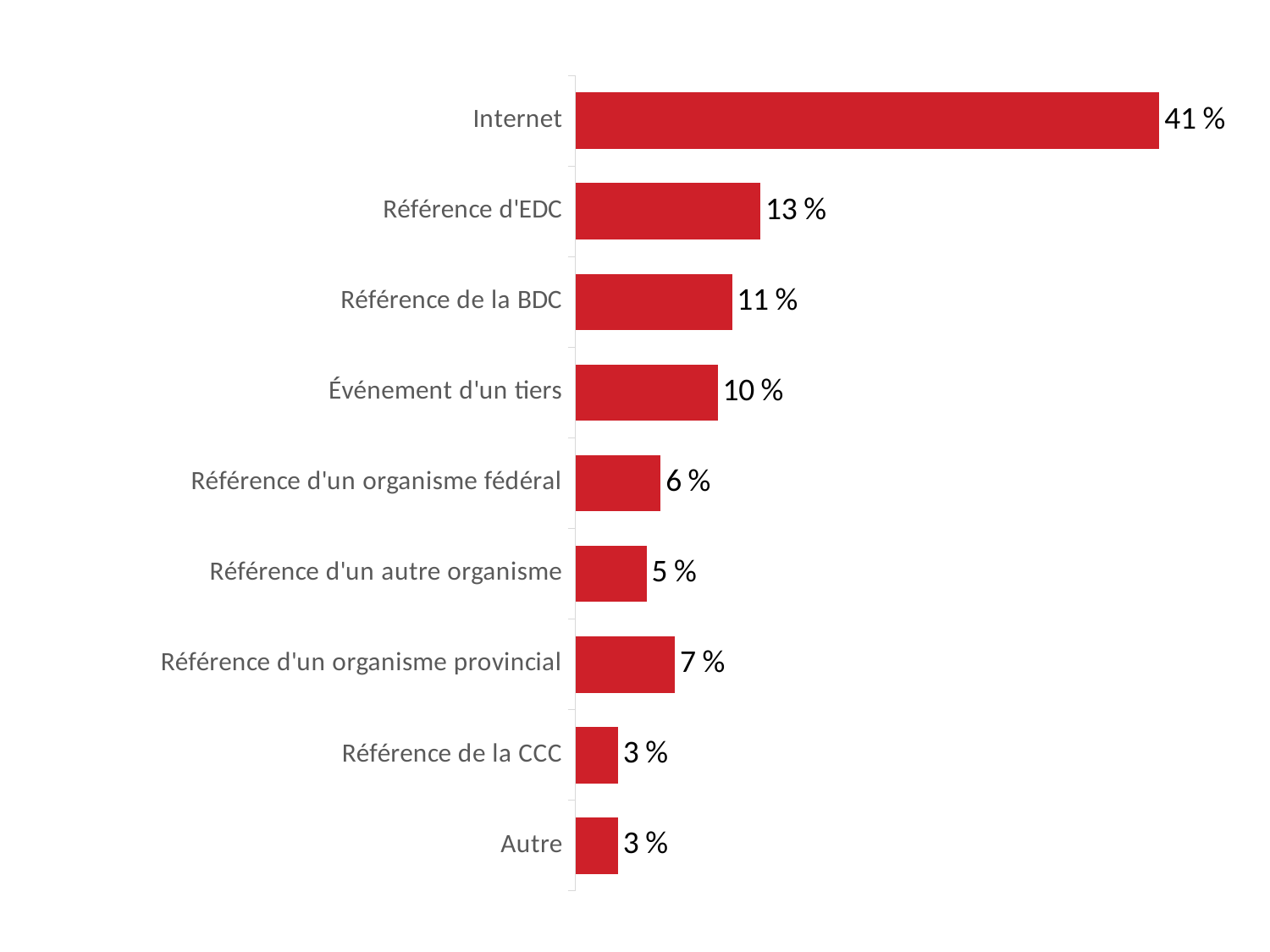
Which category has the highest value? Internet Which is larger, the value for Référence de la BDC or the value for Événement d'un tiers? Référence de la BDC What is the difference between the values for Événement d'un tiers and Référence d'un organisme fédéral? 4 % Which is larger, the value for Référence d'un organisme provincial or the value for Référence d'un autre organisme? Référence d'un organisme provincial What colour are the bars in the chart? Red What is the value for Référence d'EDC? 13 % What is the value for Internet? 41 % What is the difference between the values for Internet and Référence d'EDC? 28 % How many categories are shown in the chart? 9 What kind of chart is shown on the slide? Bar chart What is the value for Référence d'un organisme provincial? 7 % What is the value for Référence de la BDC? 11 %